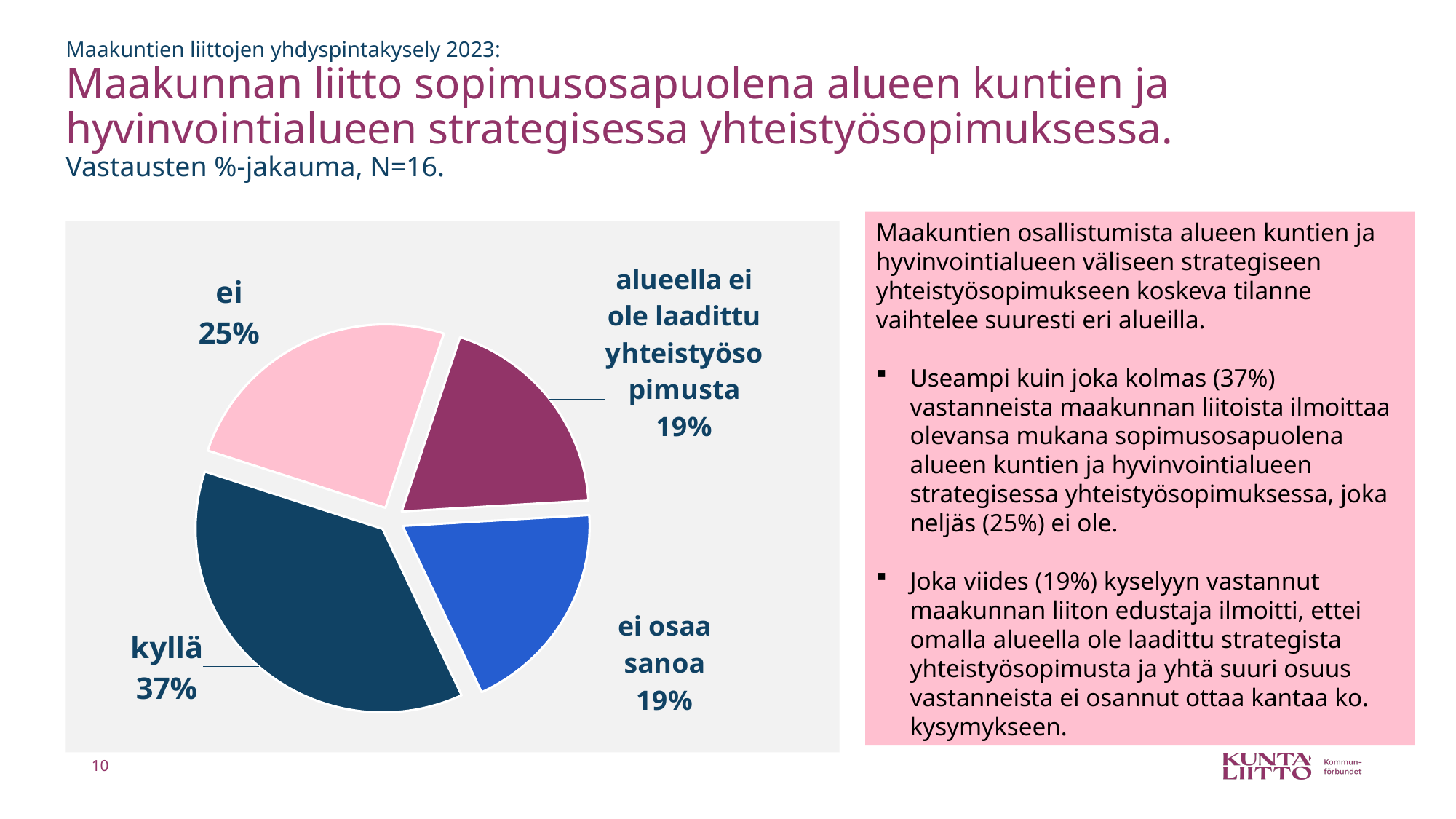
What is the difference in percentage points between 'kyllä' and 'ei'? 12 What is the difference in percentage points between 'ei' and 'alueella ei ole laadittu yhteistyösopimusta'? 6 What percentage of responses is 'alueella ei ole laadittu yhteistyösopimusta'? 19% Which is larger, the share for 'ei' or the share for 'ei osaa sanoa'? ei How many slices does the pie chart have? 4 What percentage of responses is 'ei osaa sanoa'? 19% Which category has the largest share of the pie? kyllä What kind of chart is shown on the slide? pie chart What colour is the 'kyllä' slice? dark blue What is the N (number of respondents) stated for the chart? N=16 What percentage of responses is 'ei'? 25% What percentage of responses is 'kyllä'? 37%